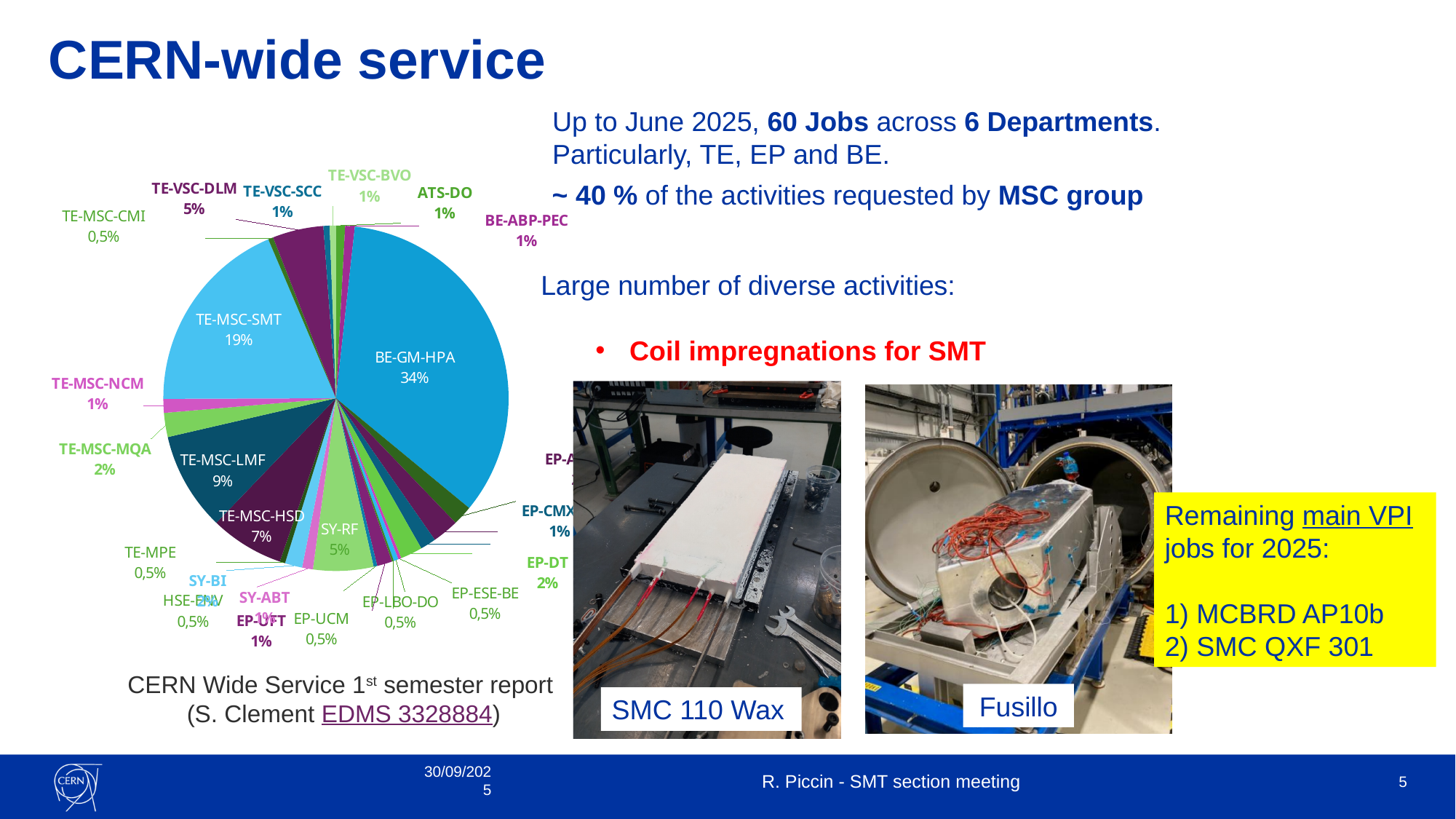
Which category has the largest share of the pie chart? BE-GM-HPA What share of the pie does BE-GM-HPA have? 34% What share of the pie does TE-MSC-MQA have? 2% What share of the pie does TE-VSC-DLM have? 5% What type of chart is shown on the slide? pie chart What is the difference in share between BE-GM-HPA and TE-MSC-SMT? 15% What share of the pie does TE-MSC-SMT have? 19% What share of the pie does TE-MSC-CMI have? 0,5% What share of the pie does SY-RF have? 5% What share of the pie does TE-MSC-LMF have? 9% What share of the pie does TE-MSC-HSD have? 7% Which has a larger share, TE-MSC-LMF or TE-MSC-HSD? TE-MSC-LMF